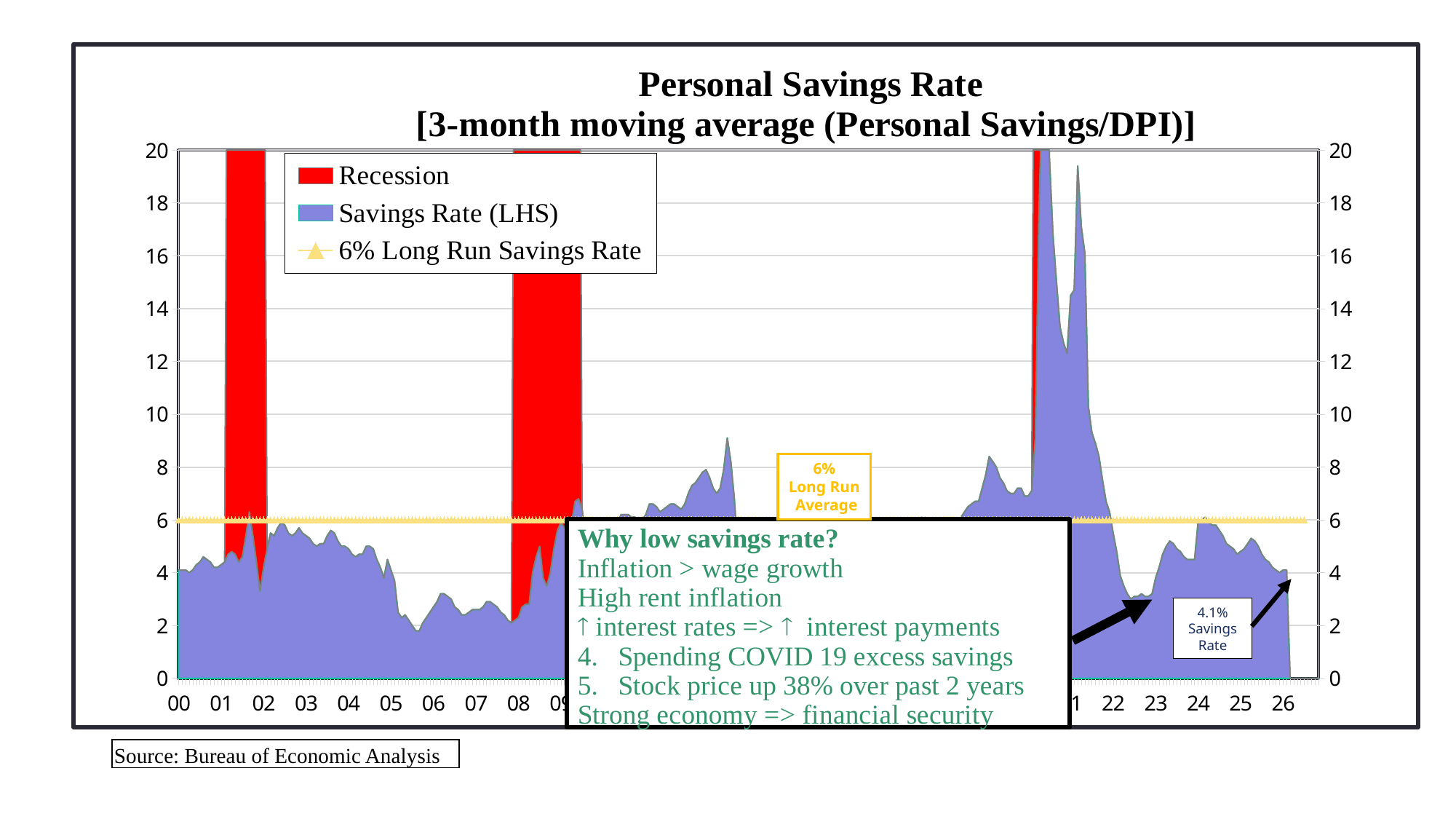
Is the peak savings rate in 2020 greater or less than 18? greater Is the savings rate in 2006 greater or less than 4? less Is the savings rate in 2023 greater or less than 6? less What is the long run savings rate shown by the horizontal line? 6% How many recession periods are shaded on the chart? 3 What is the title of the chart? Personal Savings Rate [3-month moving average (Personal Savings/DPI)] What kind of chart is used to show the savings rate? Area chart What colour is used to mark recessions on the chart? Red What is the most recent savings rate value labelled on the chart? 4.1% How many series does the chart legend list? 3 Is the savings rate in 2006 higher or lower than in 2012? lower